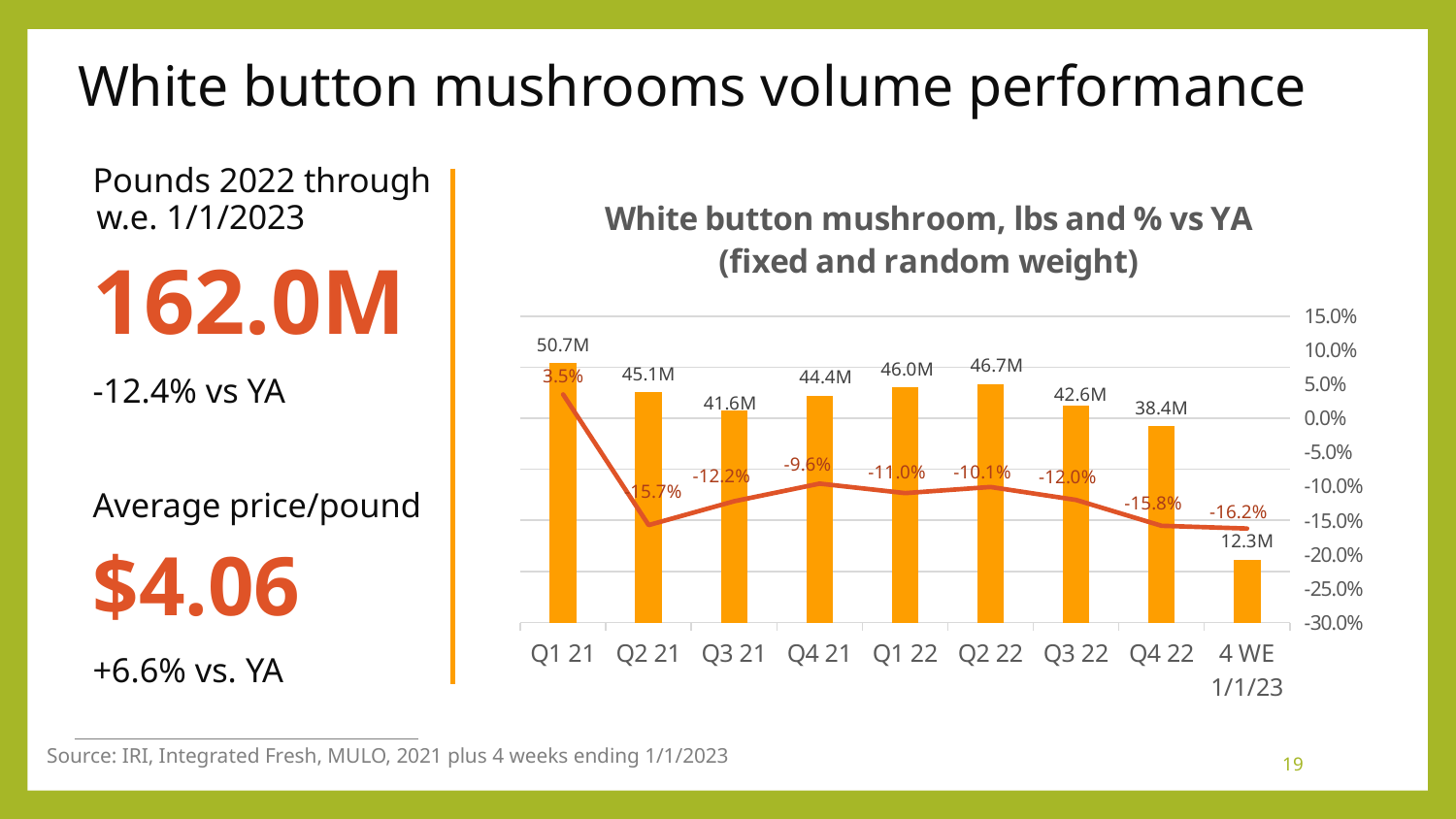
What is the % vs YA value for Q4 22? -15.8% What is the volume in pounds for Q1 21? 50.7M Which period is the only one with a positive % vs YA value? Q1 21 Which period has the lowest % vs YA value? 4 WE 1/1/23 What is the volume in pounds for the 4 WE 1/1/23 period? 12.3M How many periods are shown on the x axis? 9 Does the volume in pounds rise or fall from Q2 22 to Q4 22? Fall Which period has the highest volume in pounds? Q1 21 Which period has the larger volume in pounds, Q3 21 or Q4 21? Q4 21 What is the title of the chart? White button mushroom, lbs and % vs YA (fixed and random weight) What kind of chart is this? Combination bar and line chart What is the difference in pounds between Q2 22 and Q3 22? 4.1M